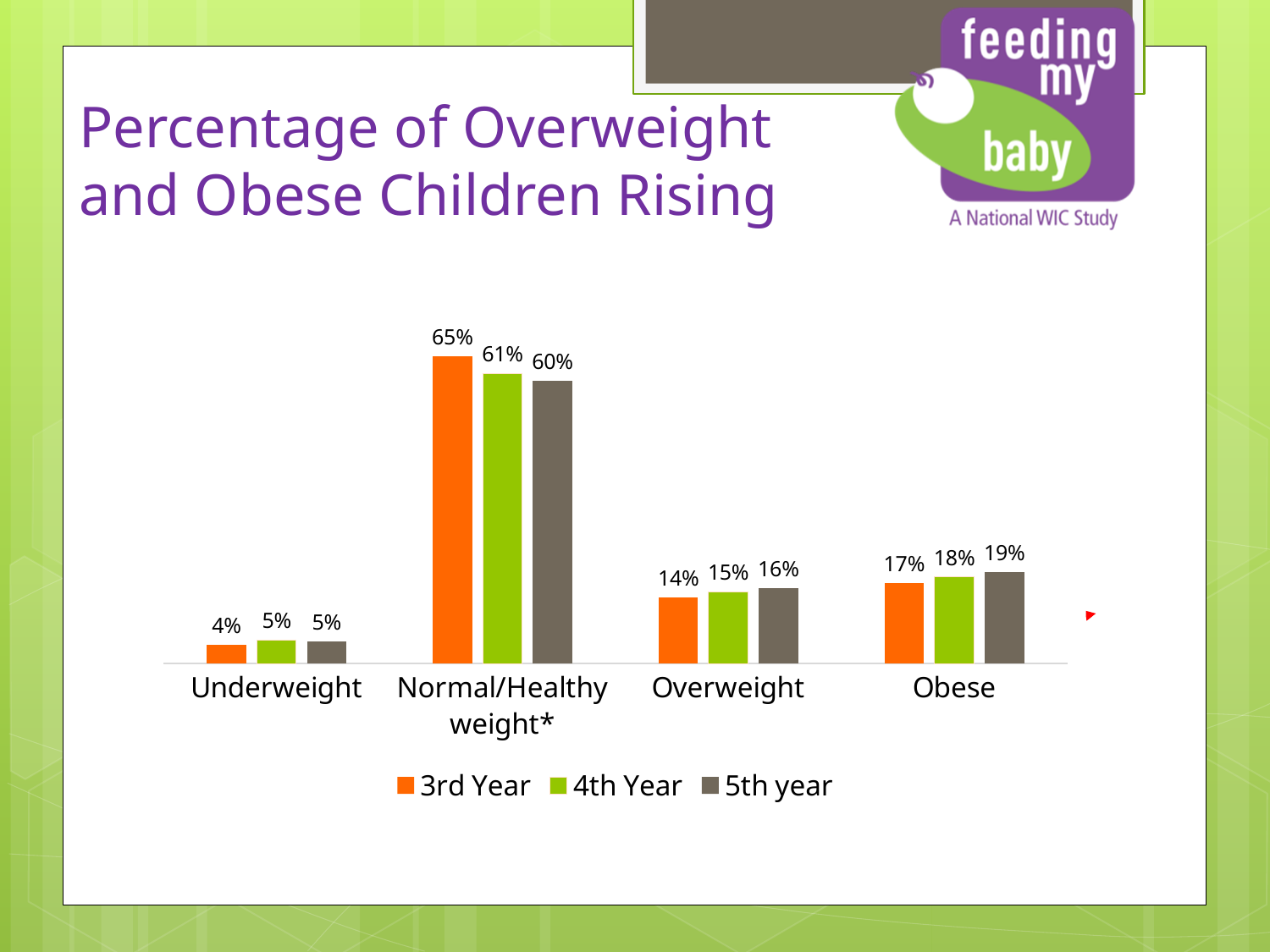
How many series does the legend list? 3 Do the values for Obese rise or fall from 3rd Year to 5th year? Rise Which category has the highest value in the 5th year series? Normal/Healthy weight* What is the difference between the 3rd Year and 5th year values for Normal/Healthy weight*? 5% What is the value for Normal/Healthy weight* in the 3rd Year series? 65% What is the value for Obese in the 5th year series? 19% What is the value for Overweight in the 4th Year series? 15% How many categories are shown on the x axis? 4 What kind of chart is shown on the slide? Bar chart What is the value for Underweight in the 3rd Year series? 4% Which is larger for Obese: the 3rd Year value or the 5th year value? 5th year Which category has the lowest value in the 4th Year series? Underweight